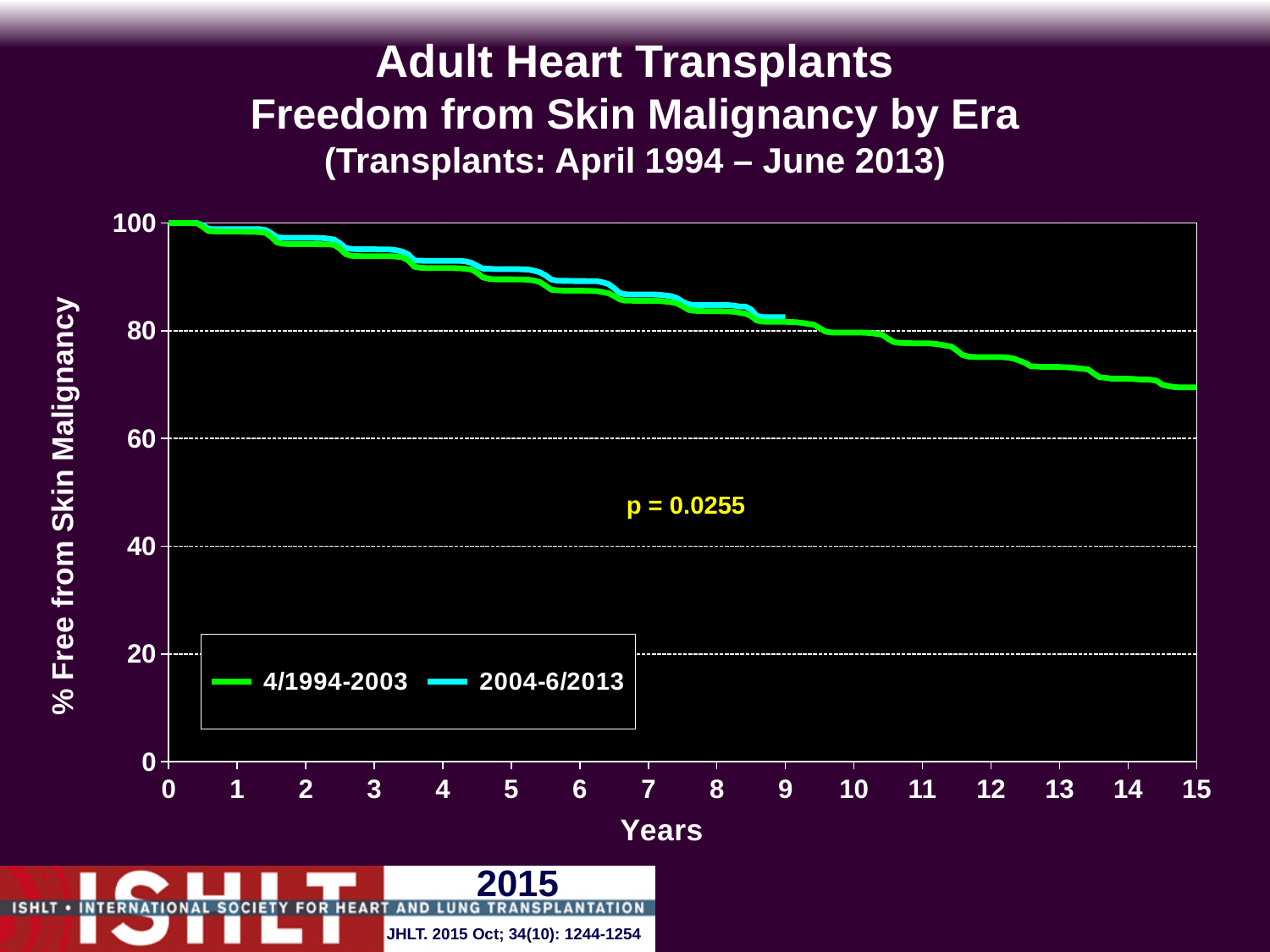
How many series does the legend list? 2 What is the highest value shown on the x axis (Years)? 15 Do the plotted values rise or fall as the years increase? fall Is the value for the 2004-6/2013 series at 5 years greater or less than 80? greater What kind of chart is shown on the slide? line chart What are the two eras listed in the legend? 4/1994-2003 and 2004-6/2013 What p-value is printed on the chart? p = 0.0255 Is the value for the 4/1994-2003 series at 15 years greater or less than 60? greater Is the value for the 4/1994-2003 series at 15 years greater or less than 80? less What is the highest value shown on the y axis? 100